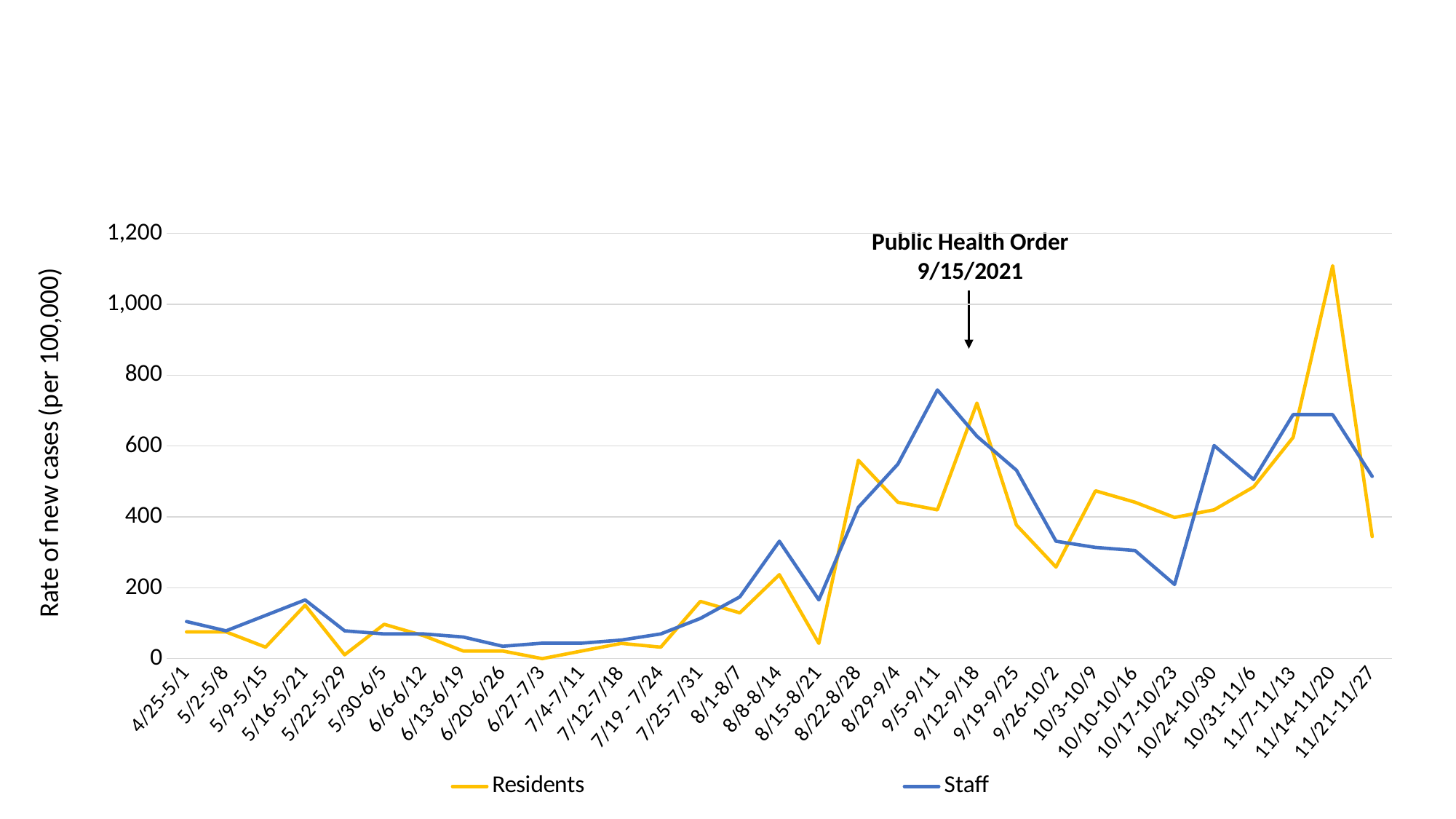
Which series has the higher value in the week 11/14-11/20, Residents or Staff? Residents How many series does the legend list? 2 Which series has the higher value in the week 9/5-9/11, Residents or Staff? Staff In which week does the Residents series reach its highest value? 11/14-11/20 Is the Residents value for 8/15-8/21 greater or less than 200? less Is the Residents value for 11/14-11/20 greater or less than 1,000? greater What date does the Public Health Order annotation on the chart give? 9/15/2021 Is the Staff value for 10/17-10/23 greater or less than 400? less What kind of chart is shown on the slide? line chart What is the label of the y axis? Rate of new cases (per 100,000) In which week does the Staff series reach its highest value? 9/5-9/11 How many weekly periods are shown along the x axis? 31